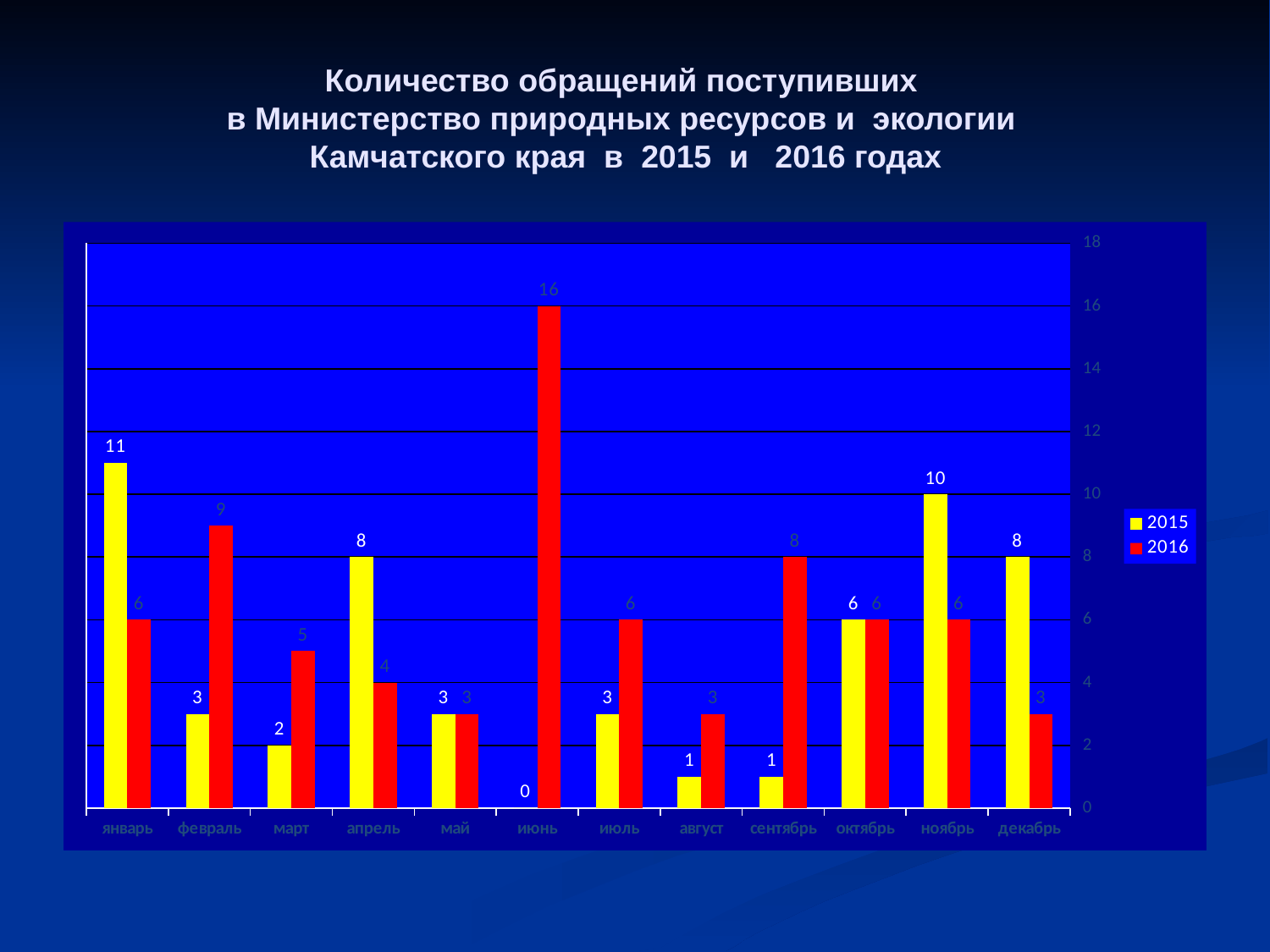
Which month has the highest value for the 2016 series? июнь How many months are shown on the x axis? 12 Which month has the lowest value for the 2015 series? июнь Which series is shown in yellow? 2015 How many series does the legend list? 2 What is the value for 2015 in июнь? 0 What is the value for 2016 in июнь? 16 What type of chart is shown on the slide? bar chart What is the value for 2016 in февраль? 9 What is the difference between the 2016 and 2015 values in сентябрь? 7 What is the value for 2015 in январь? 11 Which is larger in ноябрь, the 2015 value or the 2016 value? 2015